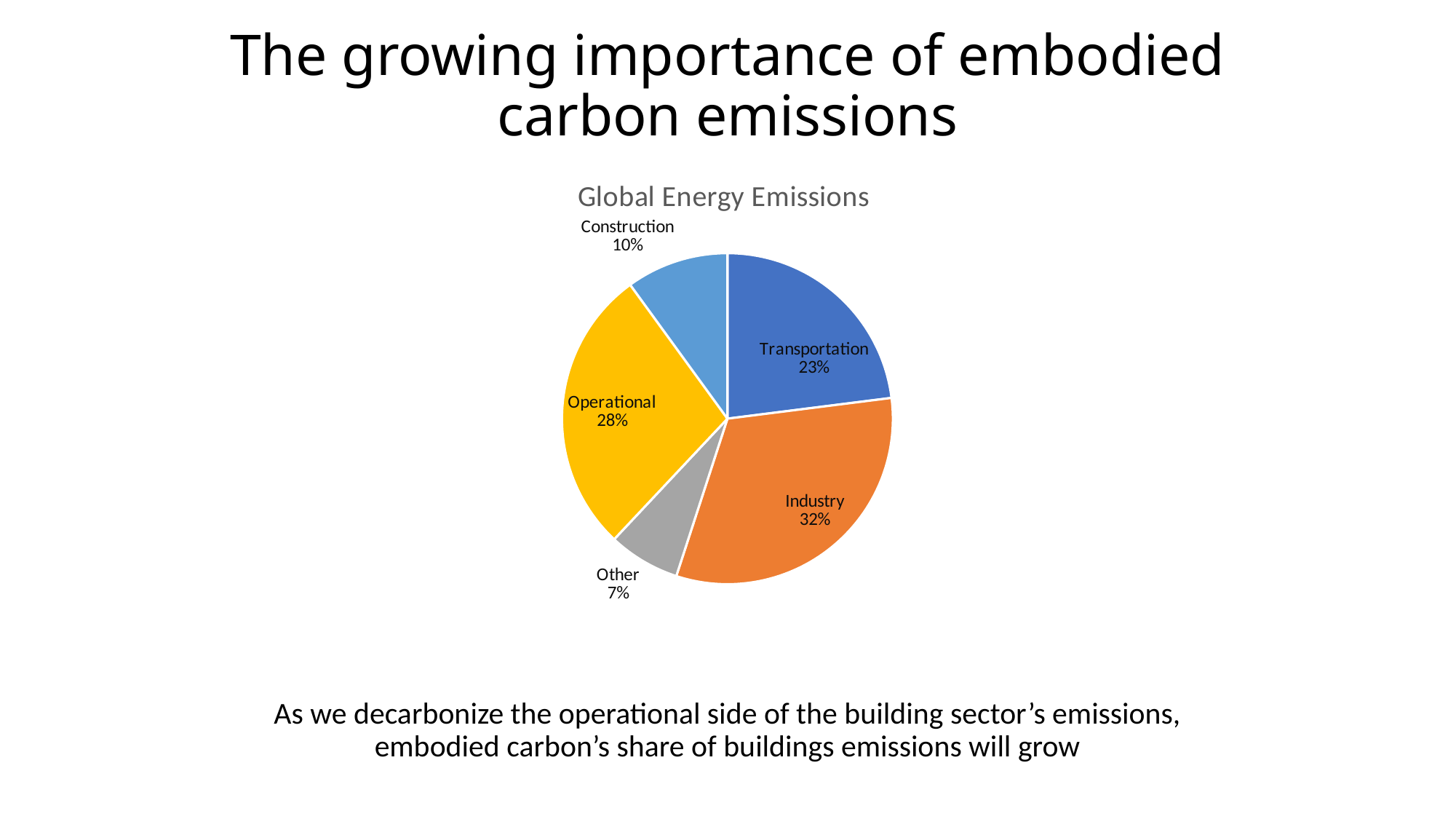
Which category has the largest slice of the pie? Industry What percentage is shown for Construction? 10% What percentage is shown for Other? 7% What percentage is shown for Operational? 28% Which is larger, the Transportation slice or the Construction slice? Transportation What type of chart is shown on the slide? pie chart What percentage is shown for Transportation? 23% What is the difference in percentage points between Industry and Operational? 4 Which category has the smallest slice of the pie? Other What share of global energy emissions does Industry account for? 32% What is the title of the chart? Global Energy Emissions How many slices does the pie chart have? 5